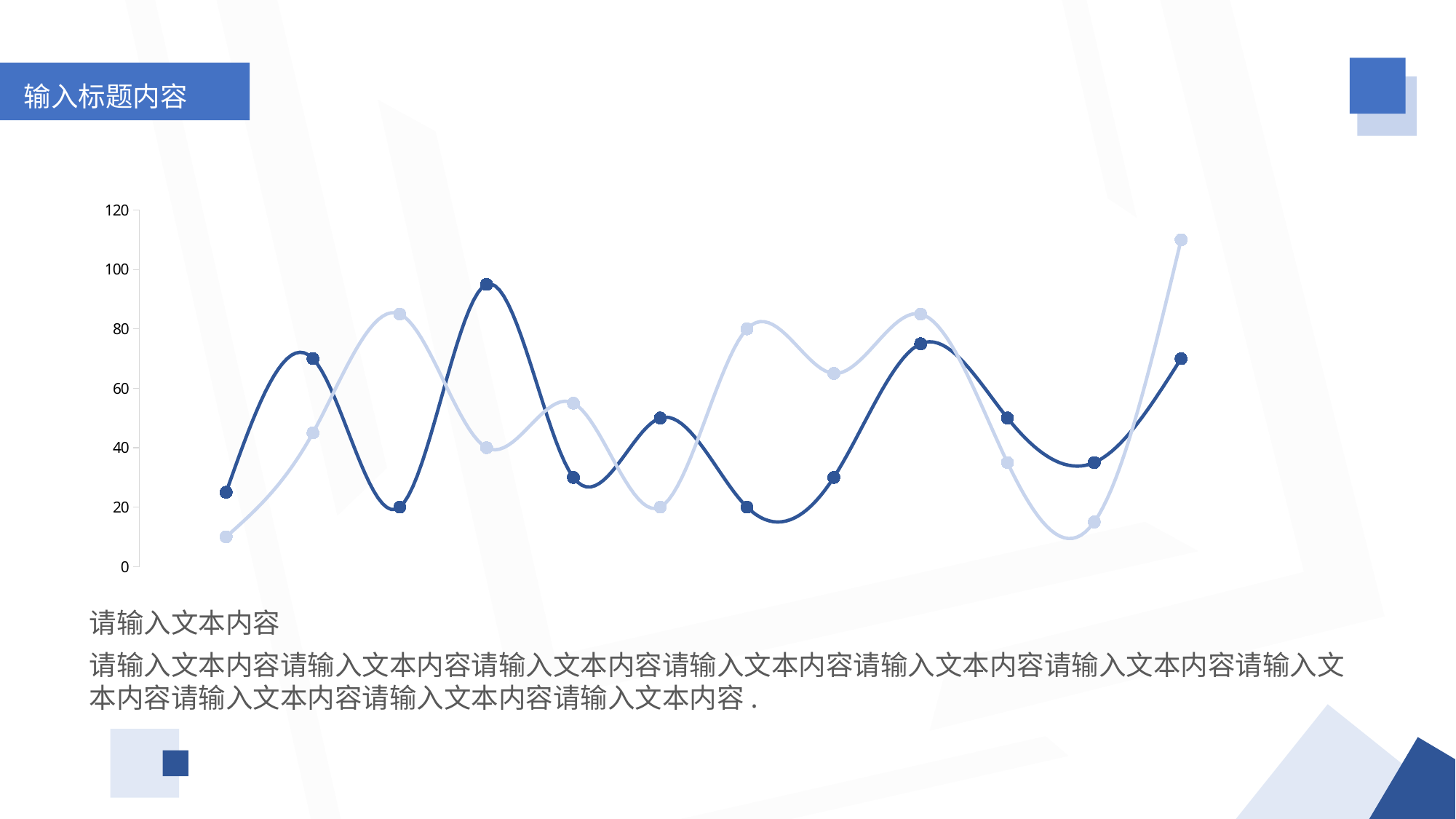
What kind of chart is shown on the slide? line chart How many data points does the dark blue line have? 12 What is the maximum value shown on the vertical axis? 120 Is the value of the fourth point from the left on the dark blue line greater or less than 80? greater What is the interval between consecutive tick marks on the vertical axis? 20 Is the value of the leftmost point on the light blue line greater or less than 20? less Is the value of the rightmost point on the light blue line greater or less than 100? greater At the far left of the chart, which line is higher, the dark blue line or the light blue line? dark blue line Which line reaches the highest value anywhere on the chart? light blue line At the far right of the chart, which line is higher, the dark blue line or the light blue line? light blue line How many lines are plotted on the chart? 2